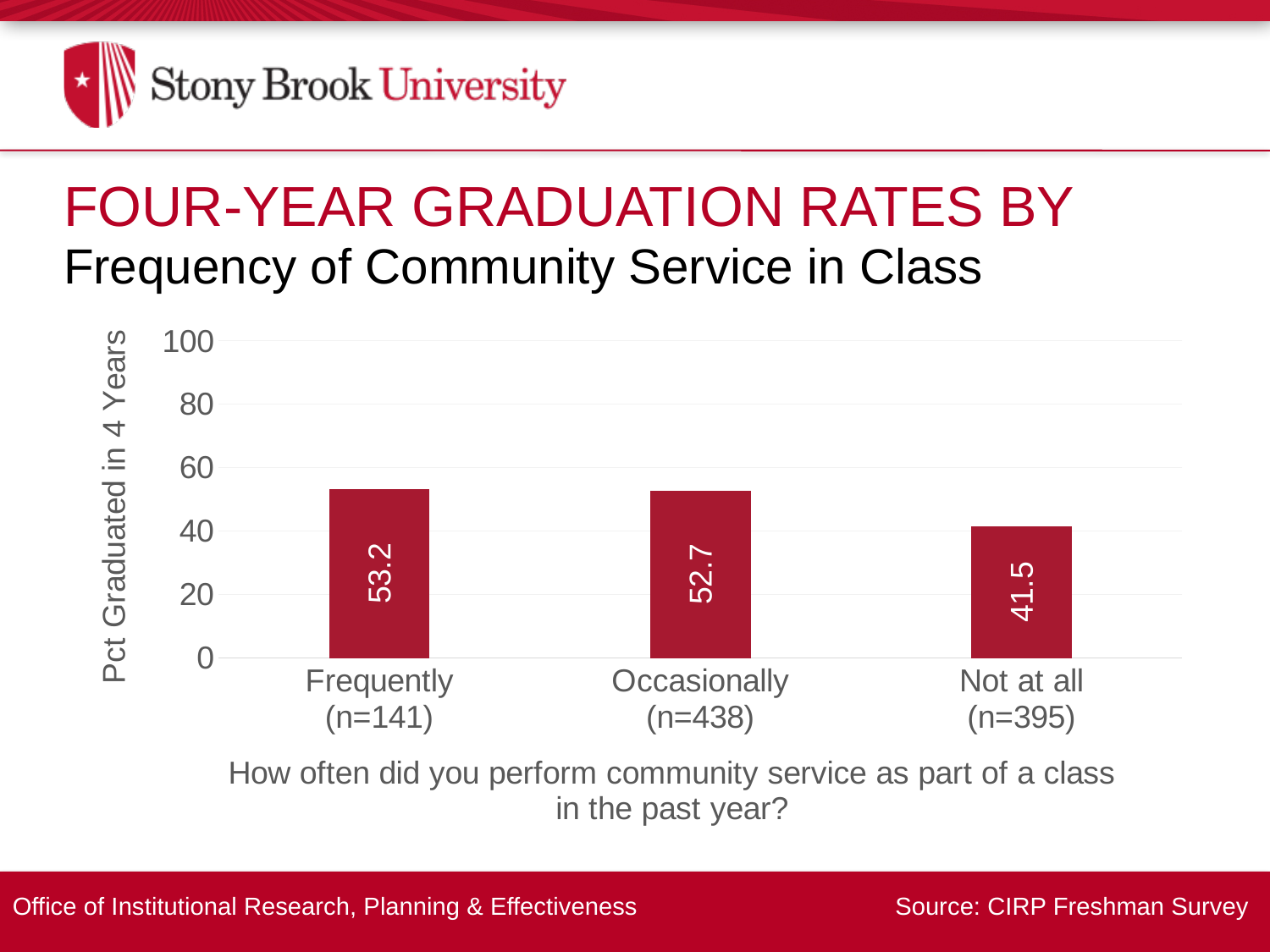
What is the difference in four-year graduation rate between the Occasionally and Not at all groups? 11.2 Is the four-year graduation rate for the Not at all group greater or less than 60? less What is the four-year graduation rate for students who did Not at all perform community service in class? 41.5 What kind of chart is shown on the slide? bar chart What is the sample size (n) for the Occasionally group? 438 What is the label of the y axis? Pct Graduated in 4 Years What is the four-year graduation rate for students who performed community service in class Occasionally? 52.7 Do the four-year graduation rates rise or fall moving from Frequently to Not at all along the x axis? fall What is the difference in four-year graduation rate between the Frequently and Not at all groups? 11.7 Which category has the lowest four-year graduation rate? Not at all How many categories are shown on the x axis of the chart? 3 What is the four-year graduation rate for students who performed community service in class Frequently? 53.2